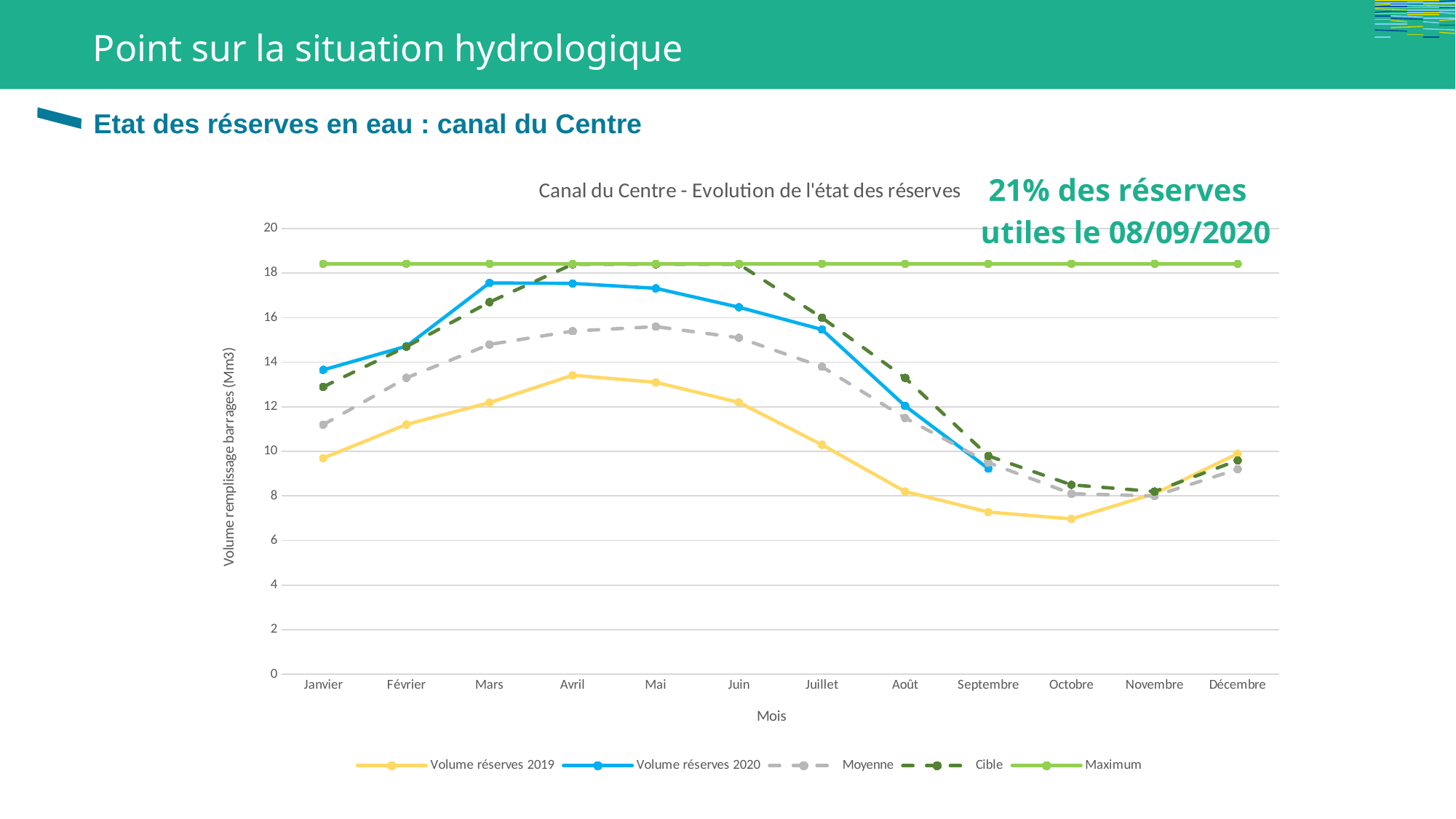
In which month is Volume réserves 2019 at its highest? Avril Is the value for Volume réserves 2020 in Mars greater or less than 16? greater In Avril, which is larger: Volume réserves 2020 or Volume réserves 2019? Volume réserves 2020 What kind of chart is shown on the slide? Line chart Is the value for Volume réserves 2019 in Janvier greater or less than 10? less Is the value for Volume réserves 2019 in Octobre greater or less than 8? less What is the label of the vertical axis? Volume remplissage barrages (Mm3) What is the title of the chart? Canal du Centre - Evolution de l'état des réserves How many series does the legend list? 5 In which month is Volume réserves 2019 at its lowest? Octobre How many months are shown on the x axis? 12